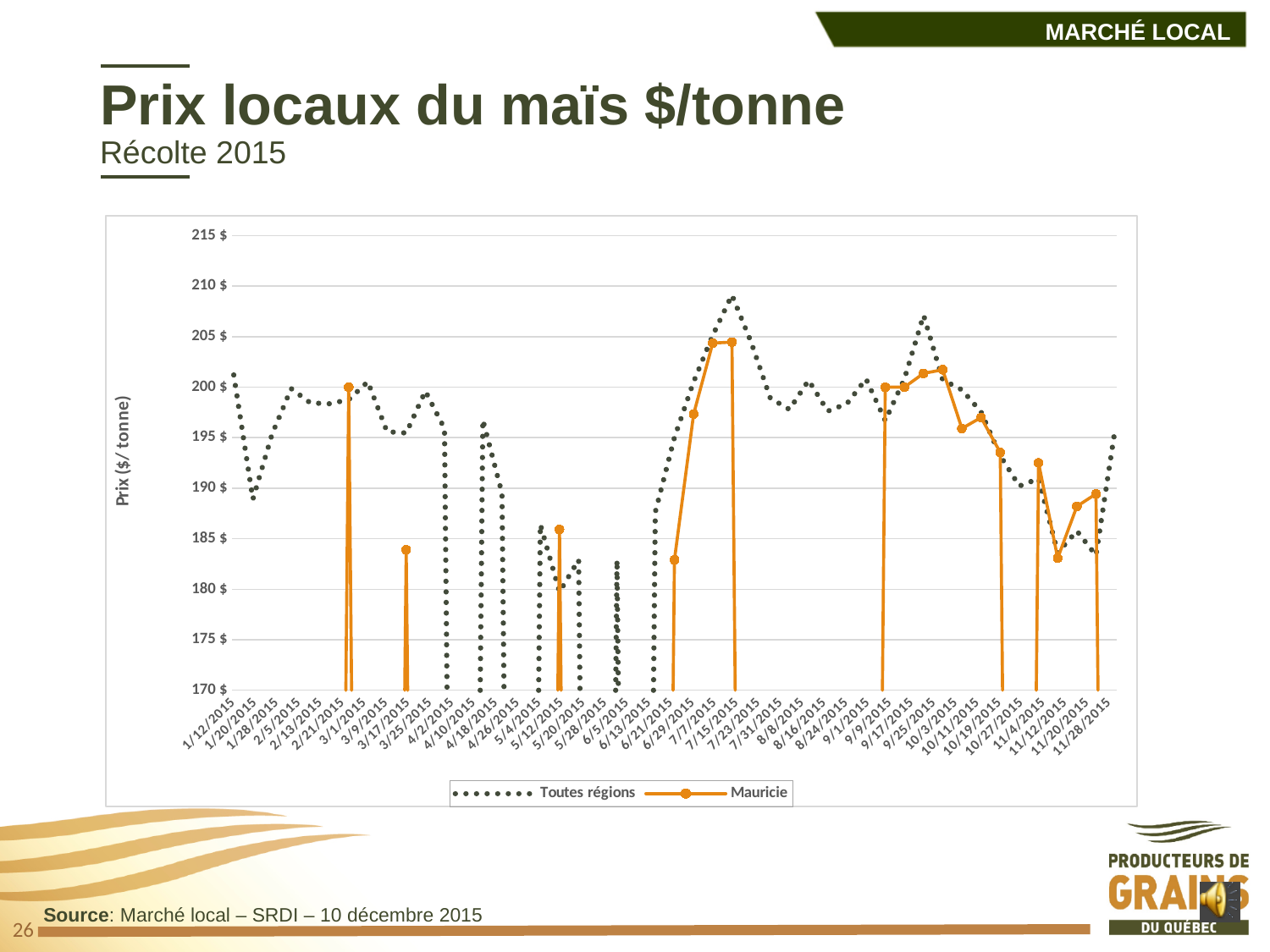
Does the Mauricie series rise or fall between 9/17/2015 and 11/20/2015? fall Which series is drawn with a dotted line? Toutes régions Around which date does the Toutes régions series reach its highest value? 7/15/2015 What is the label of the vertical axis? Prix ($/ tonne) What kind of chart is shown on the slide? line chart Is the value for Toutes régions on 7/15/2015 greater or less than 205 $? greater Is the value for Mauricie on 6/29/2015 greater or less than 190 $? greater On 9/25/2015, which series has the higher value, Toutes régions or Mauricie? Toutes régions How many series does the legend list? 2